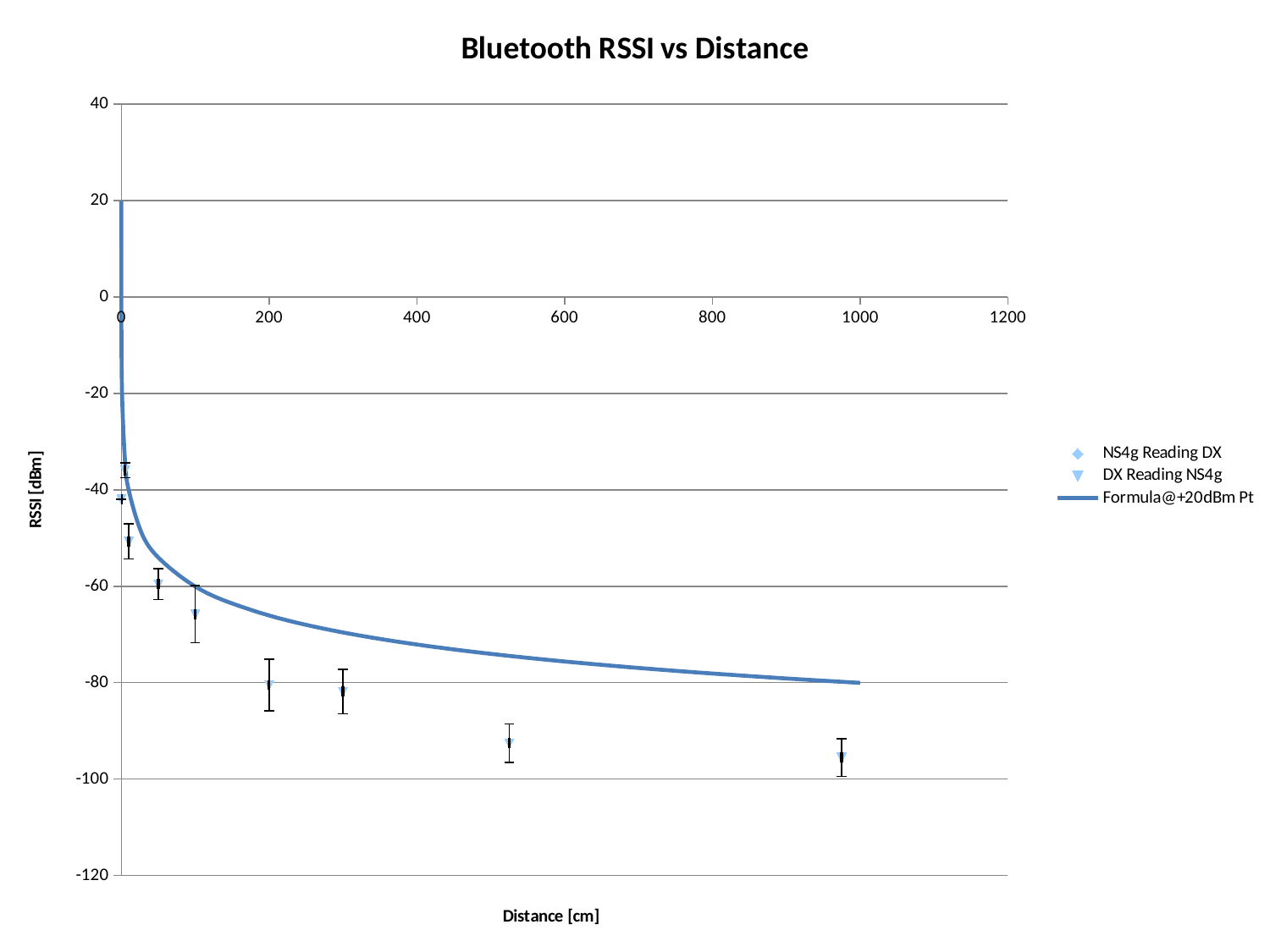
Do the RSSI values rise or fall as distance increases along the x axis? fall Which is larger at about 1000 cm: the Formula@+20dBm Pt line value or the measured reading? Formula@+20dBm Pt line value Is the Formula@+20dBm Pt line value at 600 cm greater or less than -80? greater Is the measured RSSI value at about 100 cm greater or less than -80? greater How many series does the legend list? 3 What is the label of the vertical axis? RSSI [dBm] What kind of chart is shown on the slide? scatter chart What is the title of the chart? Bluetooth RSSI vs Distance Is the Formula@+20dBm Pt line value at 200 cm greater or less than -60? less What is the highest tick value shown on the x axis? 1200